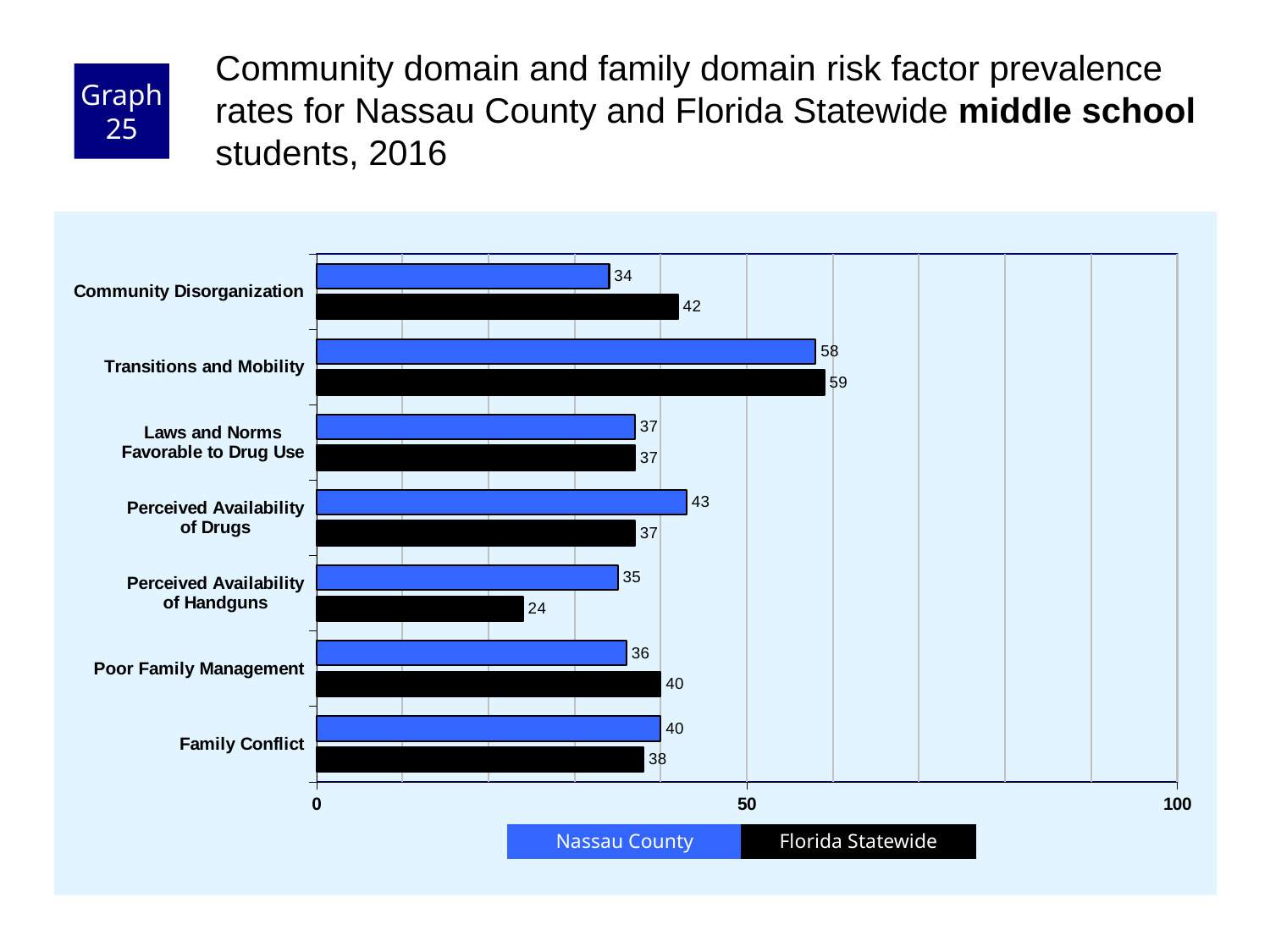
What is the Nassau County value for Perceived Availability of Drugs? 43 What is the difference between the Florida Statewide and Nassau County values for Perceived Availability of Handguns? 11 Which risk factor has the lowest Nassau County value? Community Disorganization What is the Florida Statewide value for Perceived Availability of Handguns? 24 What kind of chart is shown on the slide? Bar chart What is the Nassau County value for Community Disorganization? 34 How many series does the legend list? 2 For Poor Family Management, which is larger: the Nassau County value or the Florida Statewide value? Florida Statewide How many risk factor categories are shown on the chart? 7 Which risk factor has the highest Florida Statewide value? Transitions and Mobility What is the difference between the Florida Statewide and Nassau County values for Community Disorganization? 8 Is the Nassau County value for Transitions and Mobility greater or less than 50? greater